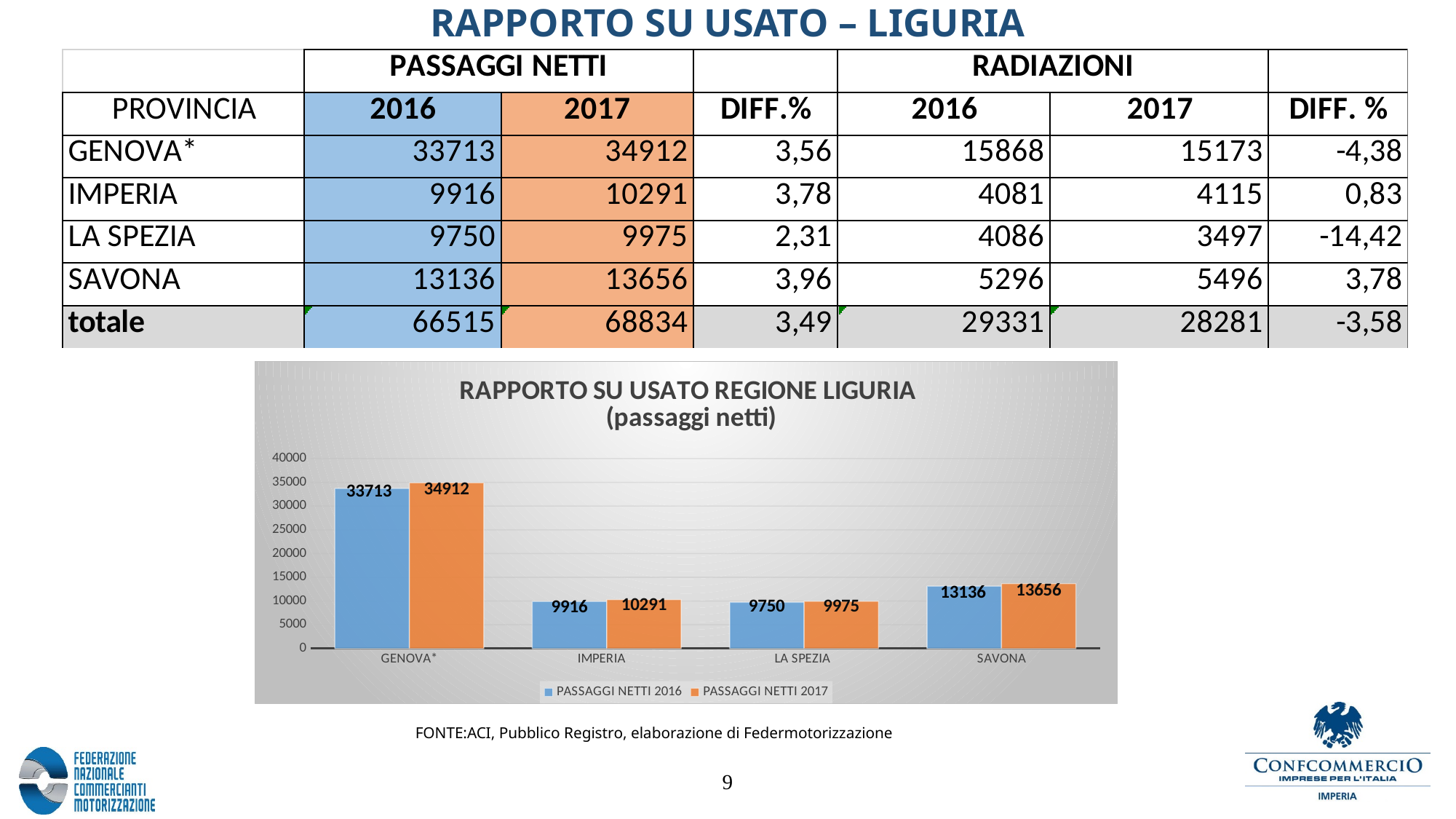
What kind of chart is shown on the slide? bar chart How many series does the chart legend list? 2 What is the title of the chart? RAPPORTO SU USATO REGIONE LIGURIA (passaggi netti) Which is larger in the chart: PASSAGGI NETTI 2016 for SAVONA or PASSAGGI NETTI 2017 for IMPERIA? PASSAGGI NETTI 2016 for SAVONA How many provinces are shown on the x axis of the chart? 4 What is the value for PASSAGGI NETTI 2017 for GENOVA* in the chart? 34912 What is the value for PASSAGGI NETTI 2016 for LA SPEZIA in the chart? 9750 Is the value for PASSAGGI NETTI 2017 for GENOVA* greater or less than 30000? greater Which province has the highest PASSAGGI NETTI 2016 value in the chart? GENOVA* What is the difference between PASSAGGI NETTI 2017 and PASSAGGI NETTI 2016 for IMPERIA in the chart? 375 Which province has the lowest PASSAGGI NETTI 2017 value in the chart? LA SPEZIA What is the value for PASSAGGI NETTI 2017 for SAVONA in the chart? 13656